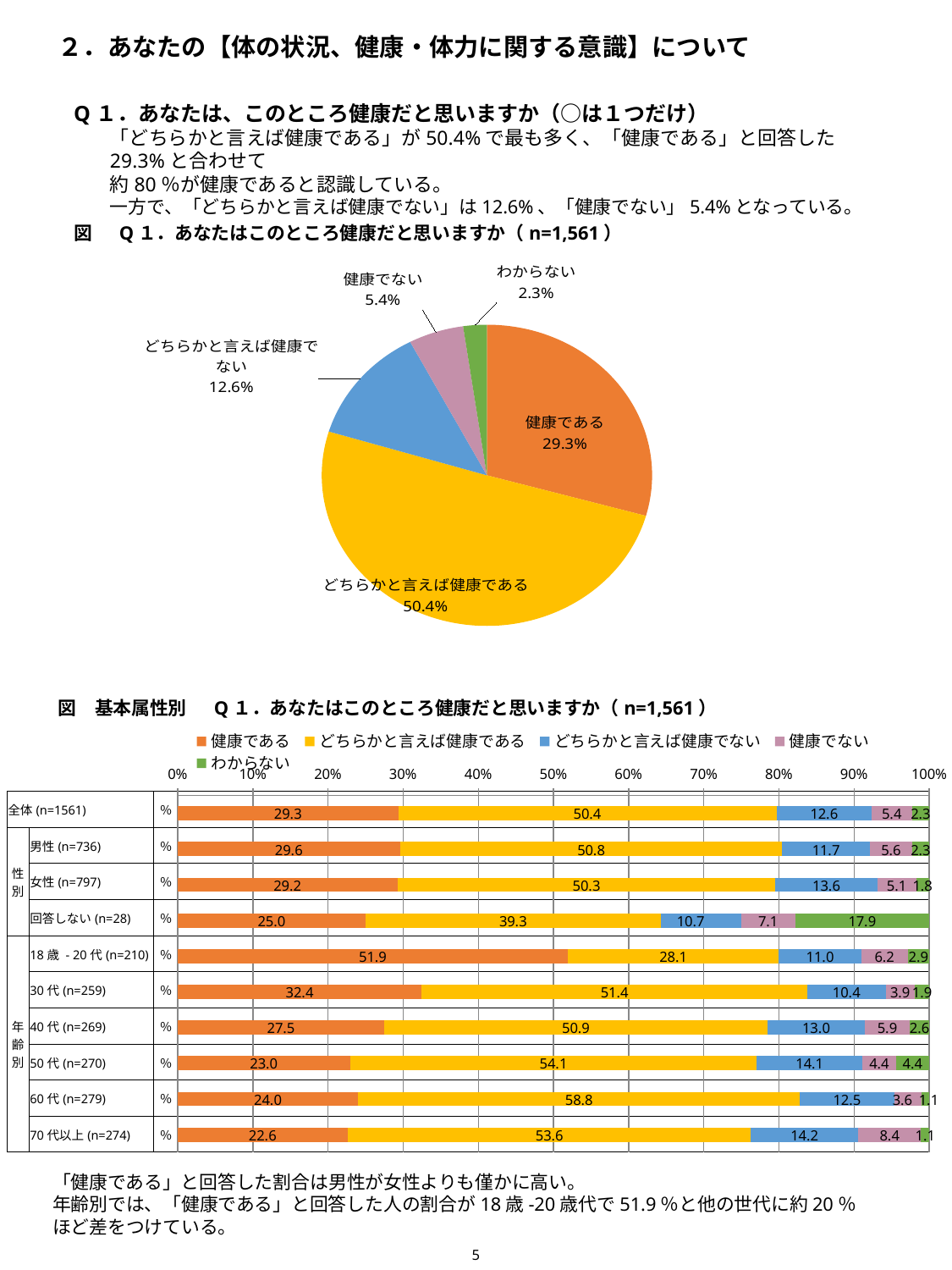
What type of chart is the lower chart (基本属性別)? Stacked bar chart How many series does the legend of the lower bar chart list? 5 In the pie chart, which category has the smallest share? わからない In the pie chart, what percentage of respondents answered 「どちらかと言えば健康である」? 50.4% In the pie chart, which category has the largest share? どちらかと言えば健康である In the lower bar chart, which is larger for 「健康である」: 男性 (n=736) or 女性 (n=797)? 男性 (n=736) In the pie chart, what is the difference between the shares of 「健康である」 and 「健康でない」? 23.9% In the lower bar chart, what is the value of 「わからない」 for 回答しない (n=28)? 17.9 In the lower bar chart, which group has the highest value for 「どちらかと言えば健康である」? 60代 (n=279) How many groups (rows) are shown in the lower bar chart? 10 How many slices does the pie chart have? 5 In the lower bar chart, what is the value of 「健康である」 for 18歳-20代 (n=210)? 51.9